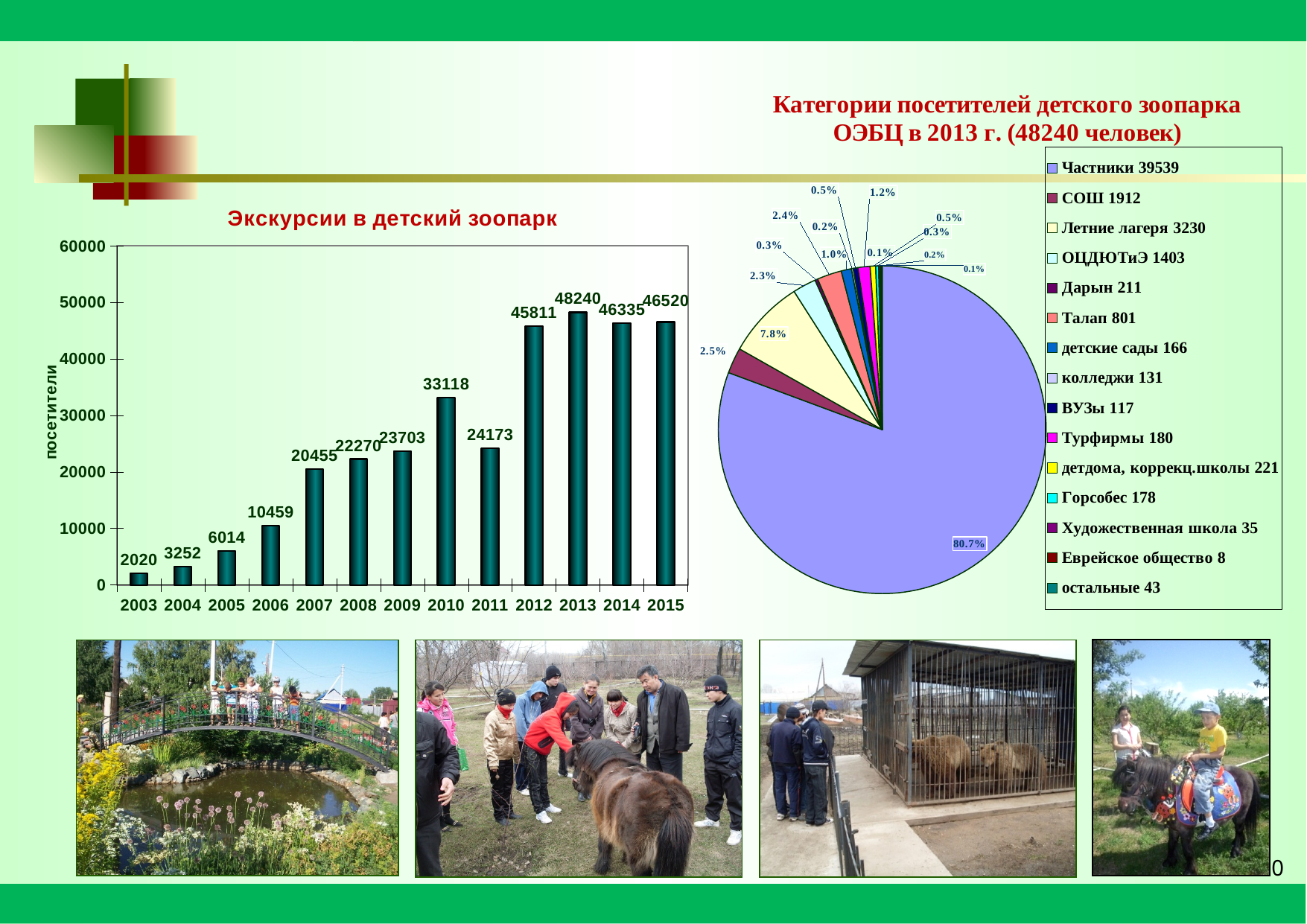
How many years are shown in the bar chart 'Экскурсии в детский зоопарк'? 13 What type of chart is 'Экскурсии в детский зоопарк'? bar chart In the bar chart 'Экскурсии в детский зоопарк', what is the difference between the values for 2013 and 2012? 2429 In the bar chart 'Экскурсии в детский зоопарк', which year has the highest number of visitors? 2013 In the bar chart 'Экскурсии в детский зоопарк', which year has the lowest number of visitors? 2003 In the bar chart 'Экскурсии в детский зоопарк', which year has the larger value, 2014 or 2015? 2015 How many categories does the legend of the pie chart 'Категории посетителей детского зоопарка ОЭБЦ в 2013 г.' list? 15 In the bar chart 'Экскурсии в детский зоопарк', how many visitors are shown for 2010? 33118 In the pie chart 'Категории посетителей детского зоопарка ОЭБЦ в 2013 г.', what percentage is labelled on the Частники slice? 80.7% In the bar chart 'Экскурсии в детский зоопарк', do the values rise or fall from 2003 to 2010? rise In the pie chart 'Категории посетителей детского зоопарка ОЭБЦ в 2013 г.', what is the number of visitors for Частники? 39539 In the pie chart 'Категории посетителей детского зоопарка ОЭБЦ в 2013 г.', which category has the largest share? Частники